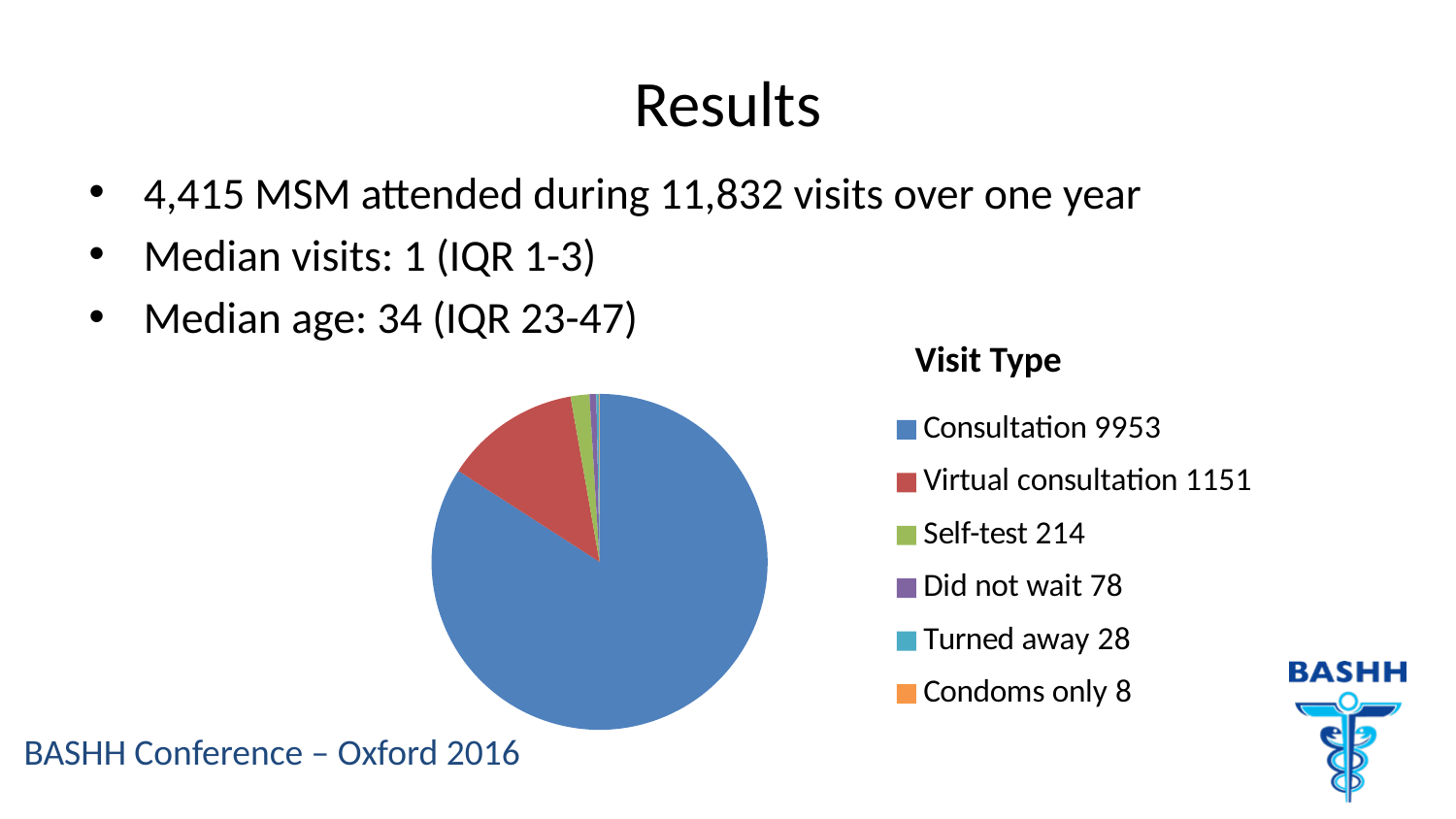
Which visit type has the smallest value in the chart? Condoms only What is the value for Turned away in the chart? 28 Which visit type has the largest slice of the pie? Consultation How many visit type categories does the pie chart show? 6 How many visits were Consultation visits according to the chart legend? 9953 What is the title of the chart? Visit Type What is the value for Self-test in the chart? 214 What is the value for Virtual consultation in the chart? 1151 Which is larger, Self-test or Did not wait? Self-test What colour is the Consultation slice of the pie? blue What kind of chart is shown on the slide? pie chart What is the difference between the Consultation and Virtual consultation values? 8802